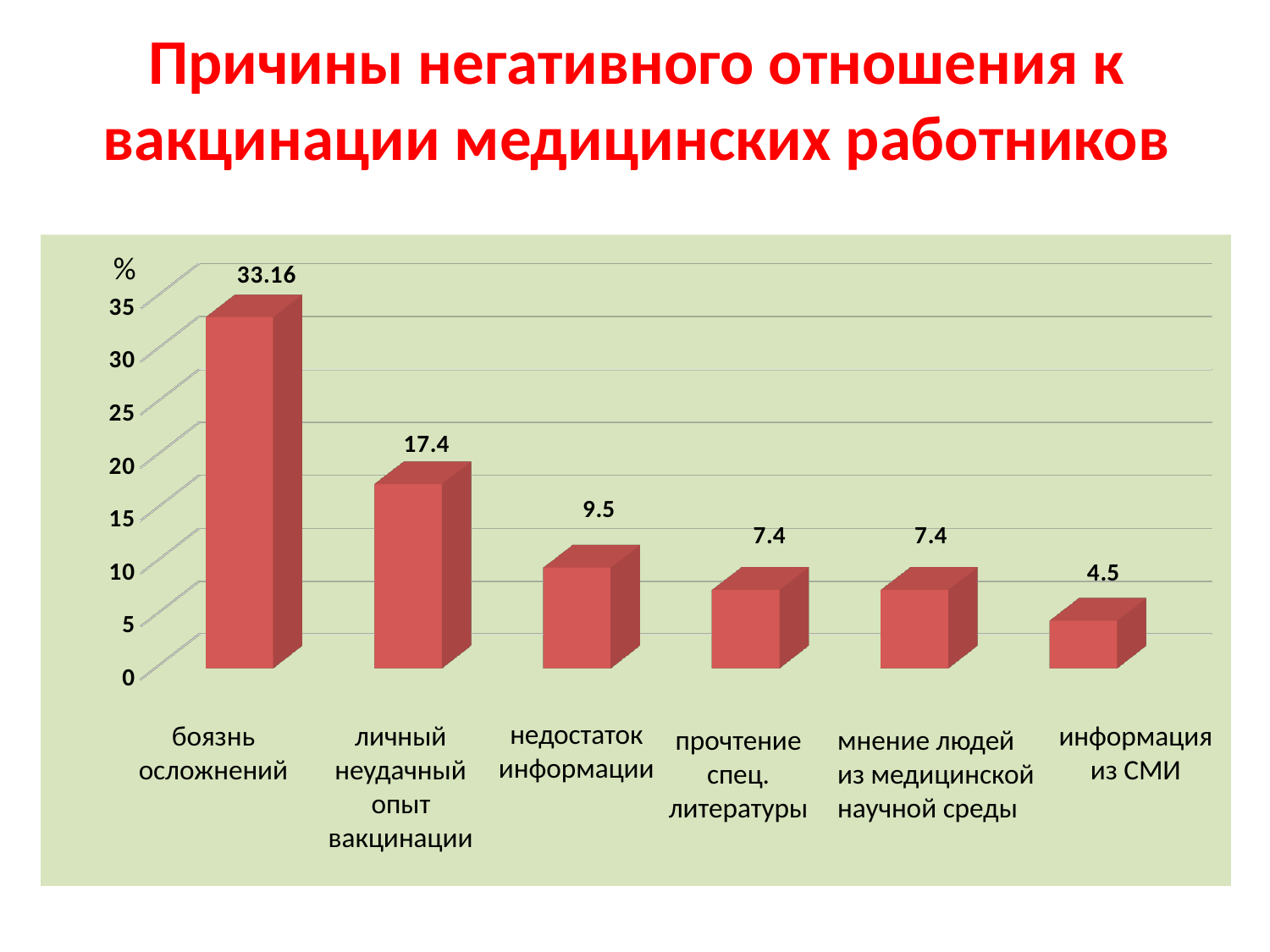
Is the value for "личный неудачный опыт вакцинации" greater or less than 15? greater How many categories are shown in the chart? 6 What is the difference between the values for "боязнь осложнений" and "личный неудачный опыт вакцинации"? 15.76 What is the value for "личный неудачный опыт вакцинации"? 17.4 Which category has the lowest value? информация из СМИ Which category has the highest value? боязнь осложнений Which is larger: the value for "недостаток информации" or the value for "прочтение спец. литературы"? недостаток информации Do the values rise or fall from left to right along the x axis? fall What is the value for "информация из СМИ"? 4.5 What is the value for "боязнь осложнений"? 33.16 What kind of chart is shown on the slide? bar chart What is the value for "недостаток информации"? 9.5